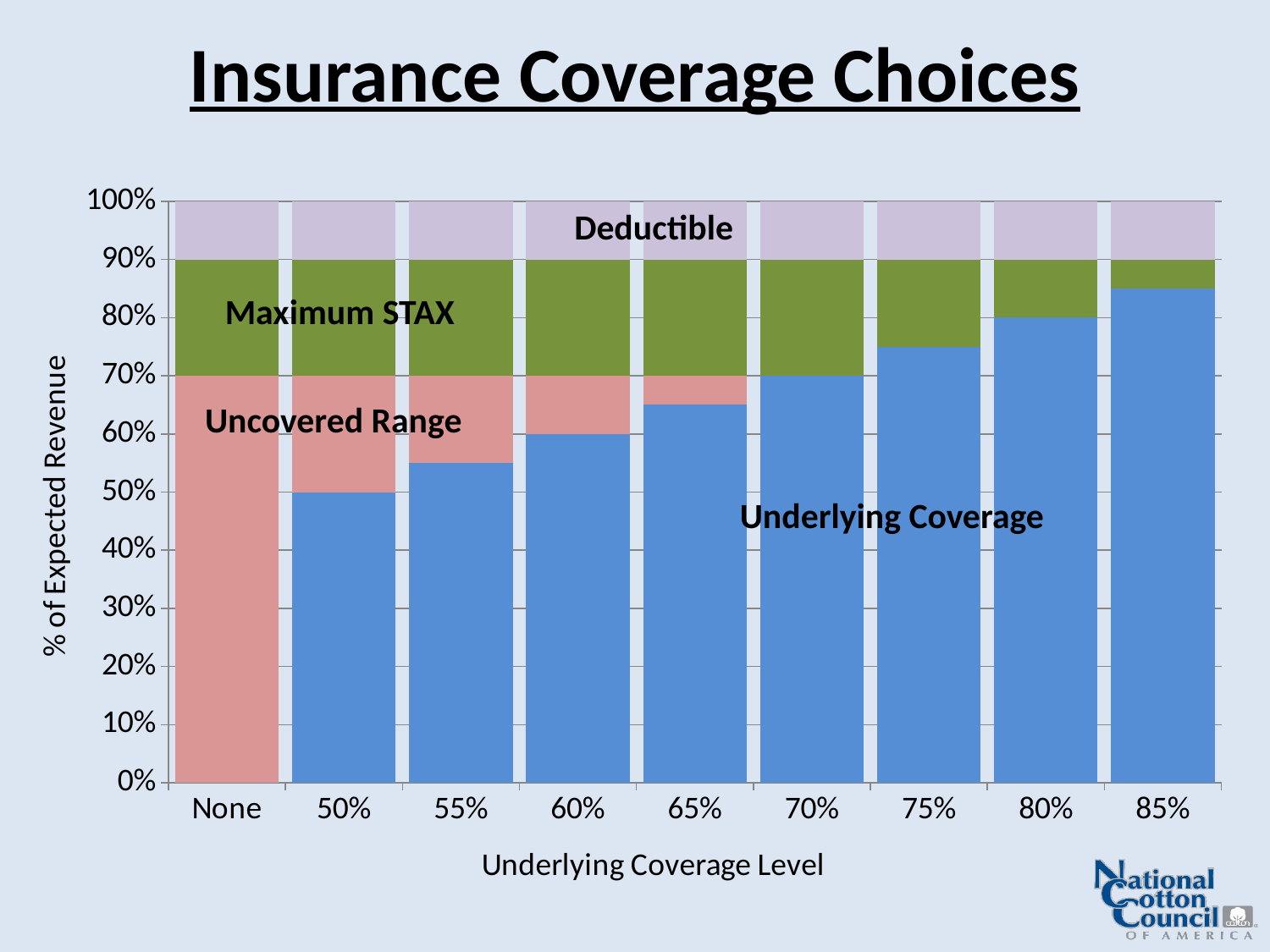
What is the difference between the Underlying Coverage values at the 80% and 50% coverage levels? 30% What is the label on the y axis of the chart? % of Expected Revenue What is the Underlying Coverage value for the 80% coverage level? 80% How many underlying coverage level categories are shown on the x axis? 9 Which category has the largest Uncovered Range segment? None What kind of chart is shown on the slide? Stacked bar chart Which coverage level has the largest Underlying Coverage segment? 85% Does the Underlying Coverage segment rise or fall as the coverage level increases along the x axis? Rises What is the Uncovered Range value for the None category? 70% Is the Uncovered Range segment for the 65% coverage level greater or less than 10%? less Is the Underlying Coverage value for the 85% coverage level greater or less than 80%? greater What is the Underlying Coverage value for the 50% coverage level? 50%